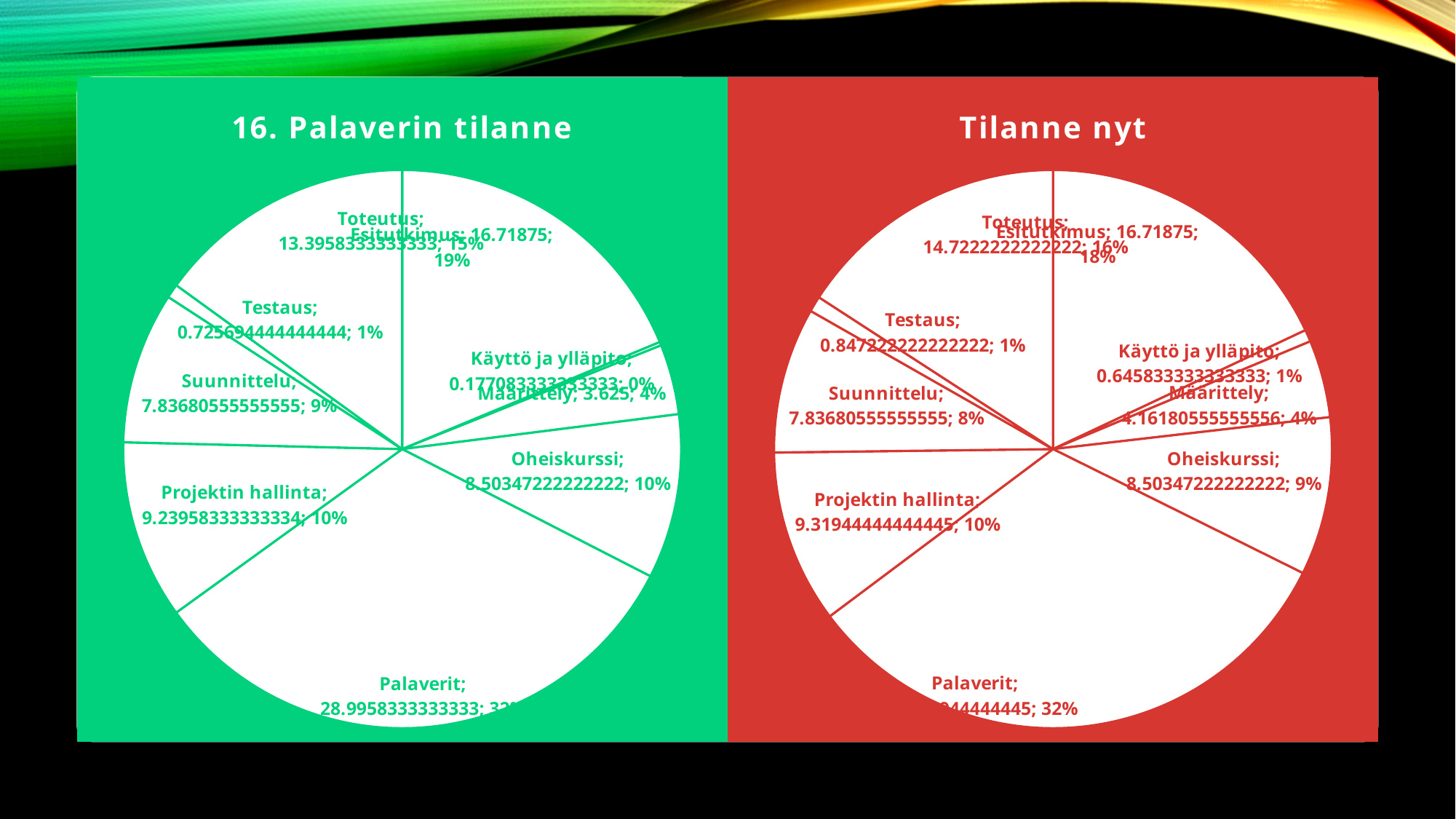
What is the title of the chart on the right side of the slide? Tilanne nyt In the "Tilanne nyt" chart, how many slices does the pie have? 9 In the "16. Palaverin tilanne" chart, what is the value for Oheiskurssi? 8.50347222222222 What kind of chart is shown under the title "16. Palaverin tilanne"? pie chart In the "16. Palaverin tilanne" chart, what share of the pie is Suunnittelu? 9% In the "Tilanne nyt" chart, which is larger, Suunnittelu or Oheiskurssi? Oheiskurssi In the "16. Palaverin tilanne" chart, which category has the largest slice? Palaverit In the "Tilanne nyt" chart, what is the value for Projektin hallinta? 9.31944444444445 In the "16. Palaverin tilanne" chart, what share of the pie is Palaverit? 32% In the "Tilanne nyt" chart, what share of the pie is Testaus? 1% In the "16. Palaverin tilanne" chart, which category has the smallest slice? Käyttö ja ylläpito